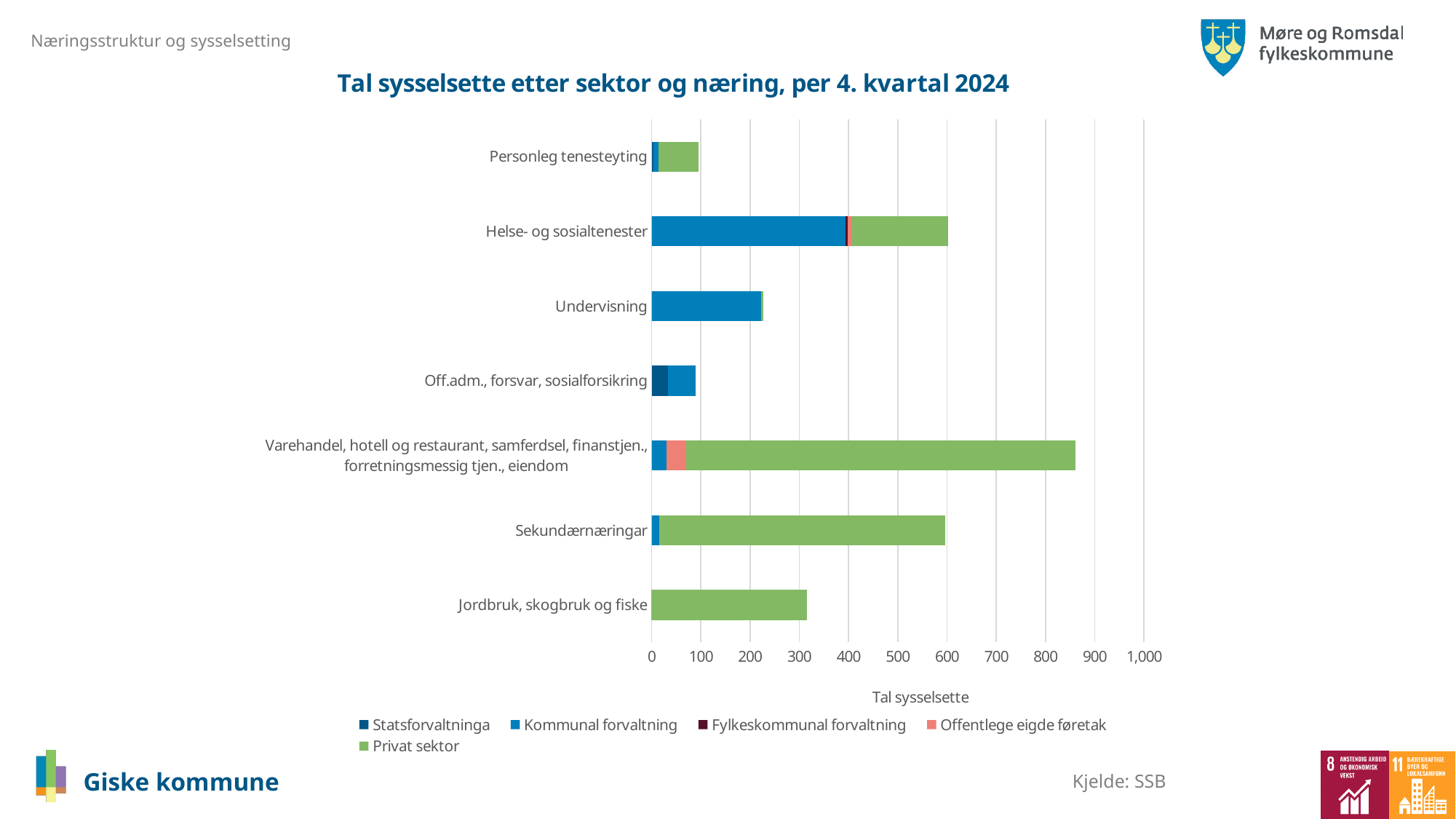
Is the total value for Undervisning greater or less than 200? greater What kind of chart is shown on the slide? Stacked bar chart How many industry categories are shown on the y axis of the chart? 7 What is the title of the chart? Tal sysselsette etter sektor og næring, per 4. kvartal 2024 Which has a larger total bar, Helse- og sosialtenester or Undervisning? Helse- og sosialtenester Is the total value for Varehandel, hotell og restaurant, samferdsel, finanstjen., forretningsmessig tjen., eiendom greater or less than 800? greater How many series does the legend list? 5 Which category has the longest total bar? Varehandel, hotell og restaurant, samferdsel, finanstjen., forretningsmessig tjen., eiendom Is the total value for Jordbruk, skogbruk og fiske greater or less than 200? greater Which series in the legend is shown in green? Privat sektor